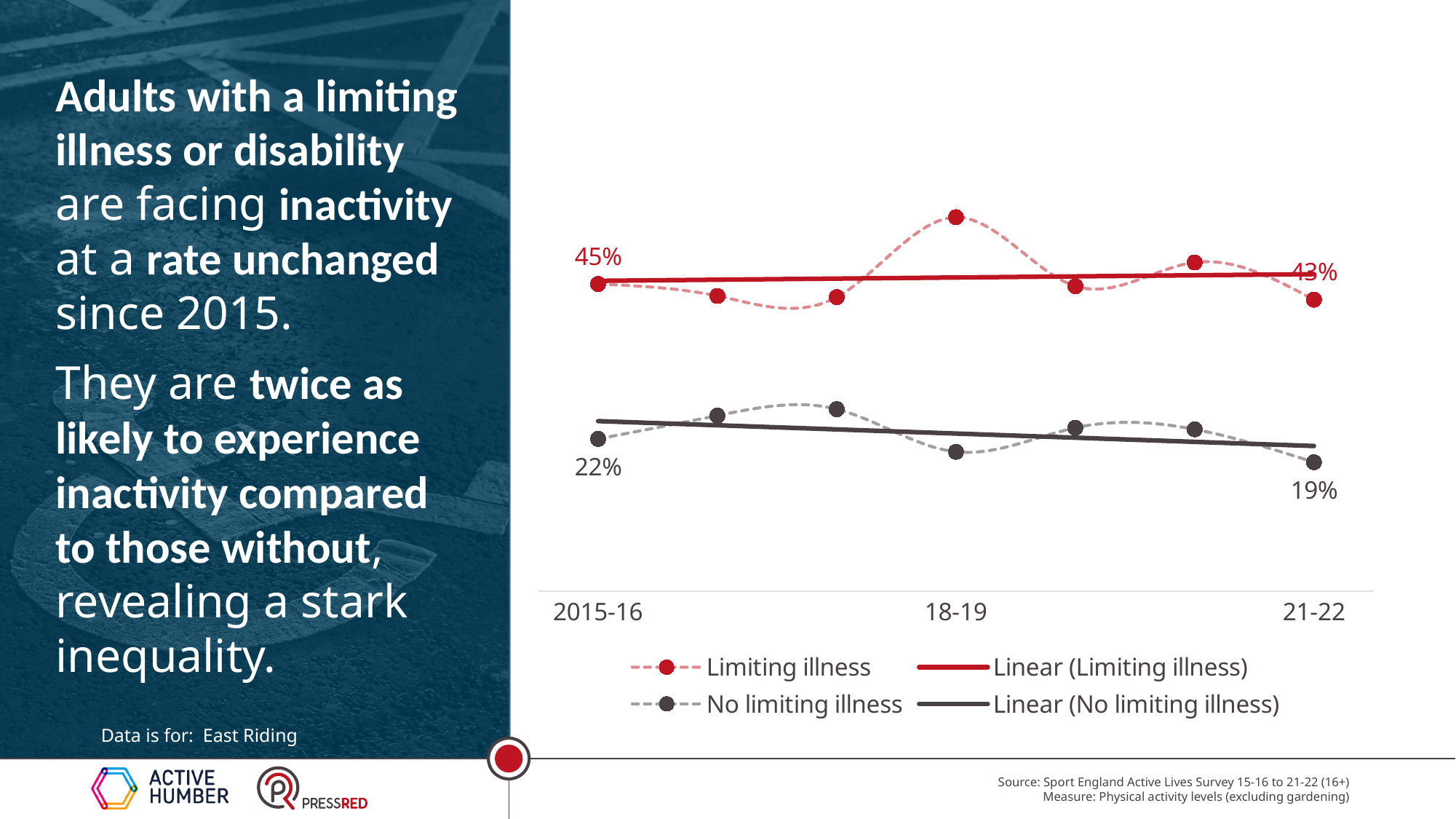
What is the inactivity rate for the Limiting illness series in 2015-16? 45% What is the inactivity rate for the Limiting illness series in 21-22? 43% How many entries does the chart legend list? 4 In 2015-16, what is the difference between the Limiting illness and No limiting illness rates? 23 percentage points By how much did the No limiting illness rate change from 2015-16 to 21-22? 3 percentage points What is the inactivity rate for the No limiting illness series in 21-22? 19% What is the inactivity rate for the No limiting illness series in 2015-16? 22% What type of chart is shown on the slide? Line chart In which year does the Limiting illness series reach its highest point? 18-19 How many data points are plotted for the Limiting illness series? 7 Which series has the higher value in 2015-16, Limiting illness or No limiting illness? Limiting illness In 21-22, what is the difference between the Limiting illness and No limiting illness rates? 24 percentage points